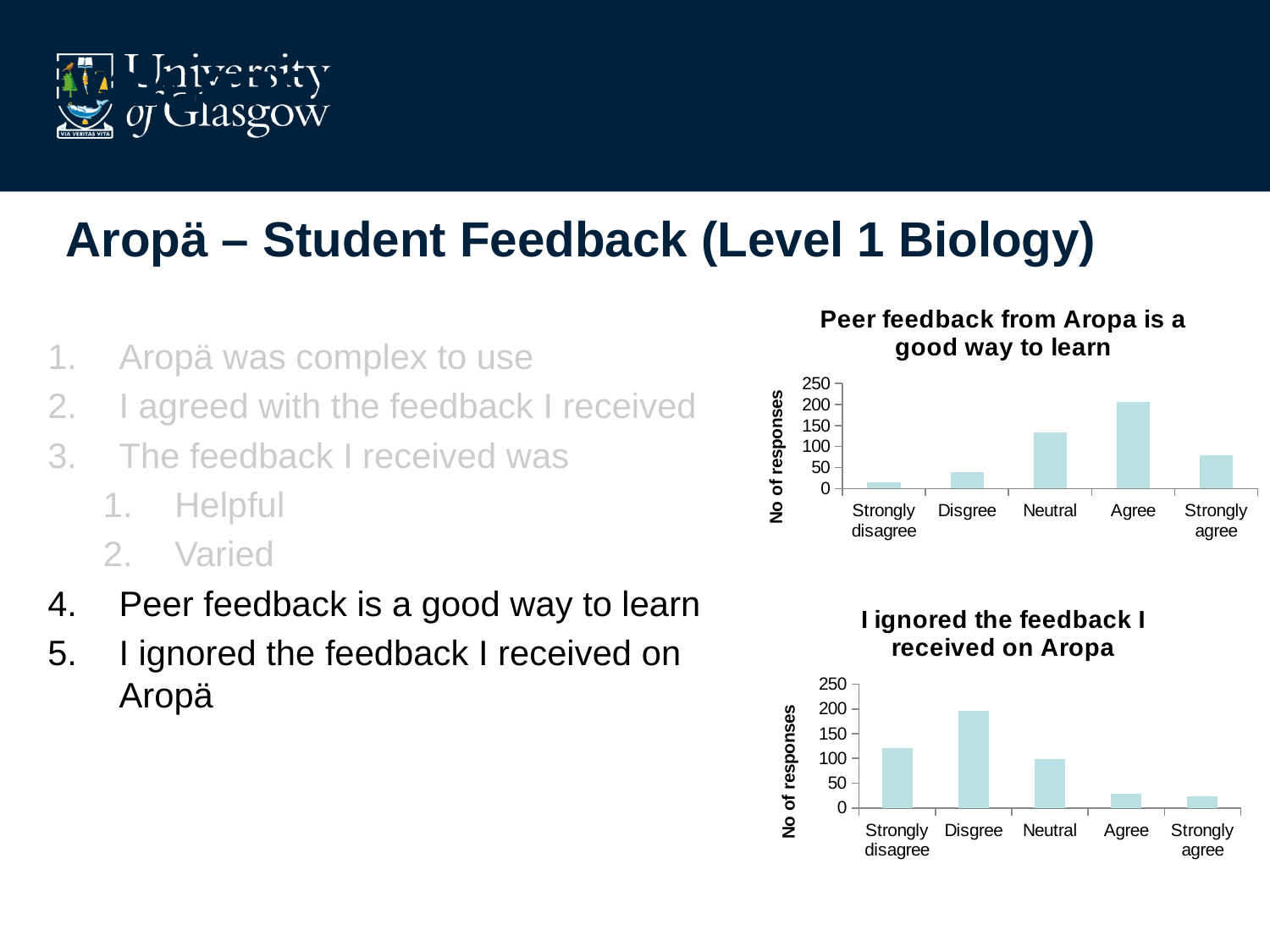
In the chart titled "Peer feedback from Aropa is a good way to learn", which category has the highest number of responses? Agree What is the y-axis label of the chart titled "I ignored the feedback I received on Aropa"? No of responses In the chart titled "I ignored the feedback I received on Aropa", is the value for Agree greater or less than 50? less In the chart titled "I ignored the feedback I received on Aropa", which is larger, the value for Strongly disagree or the value for Neutral? Strongly disagree What type of chart is the chart titled "Peer feedback from Aropa is a good way to learn"? Bar chart In the chart titled "Peer feedback from Aropa is a good way to learn", which category has the lowest number of responses? Strongly disagree How many categories are shown on the x axis of the chart titled "I ignored the feedback I received on Aropa"? 5 In the chart titled "I ignored the feedback I received on Aropa", is the value for Disgree greater or less than 150? greater In the chart titled "Peer feedback from Aropa is a good way to learn", is the value for Neutral greater or less than 100? greater In the chart titled "Peer feedback from Aropa is a good way to learn", which is larger, the value for Neutral or the value for Strongly agree? Neutral In the chart titled "I ignored the feedback I received on Aropa", which category has the highest number of responses? Disgree